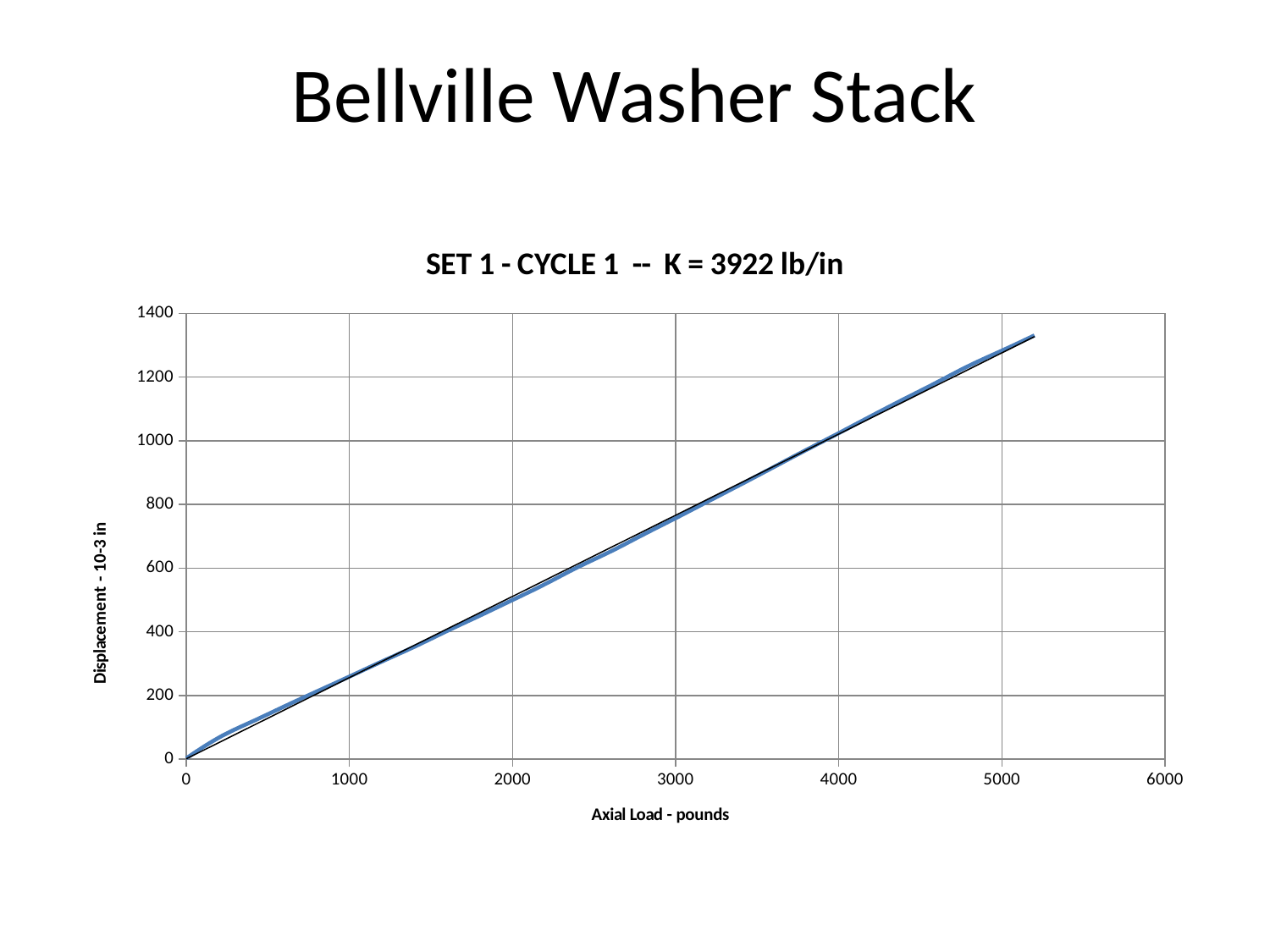
What kind of chart is shown on the slide? line chart Does the displacement rise or fall as the axial load increases along the x axis? rise What is the label of the x axis? Axial Load - pounds Is the displacement at an axial load of 1000 pounds greater or less than 200? greater Is the displacement at an axial load of 2000 pounds greater or less than 600? less Is the displacement at an axial load of 4000 pounds greater or less than 800? greater What is the stiffness value K given in the chart title? 3922 lb/in What is the title of the chart? SET 1 - CYCLE 1 -- K = 3922 lb/in What is the highest value shown on the y axis? 1400